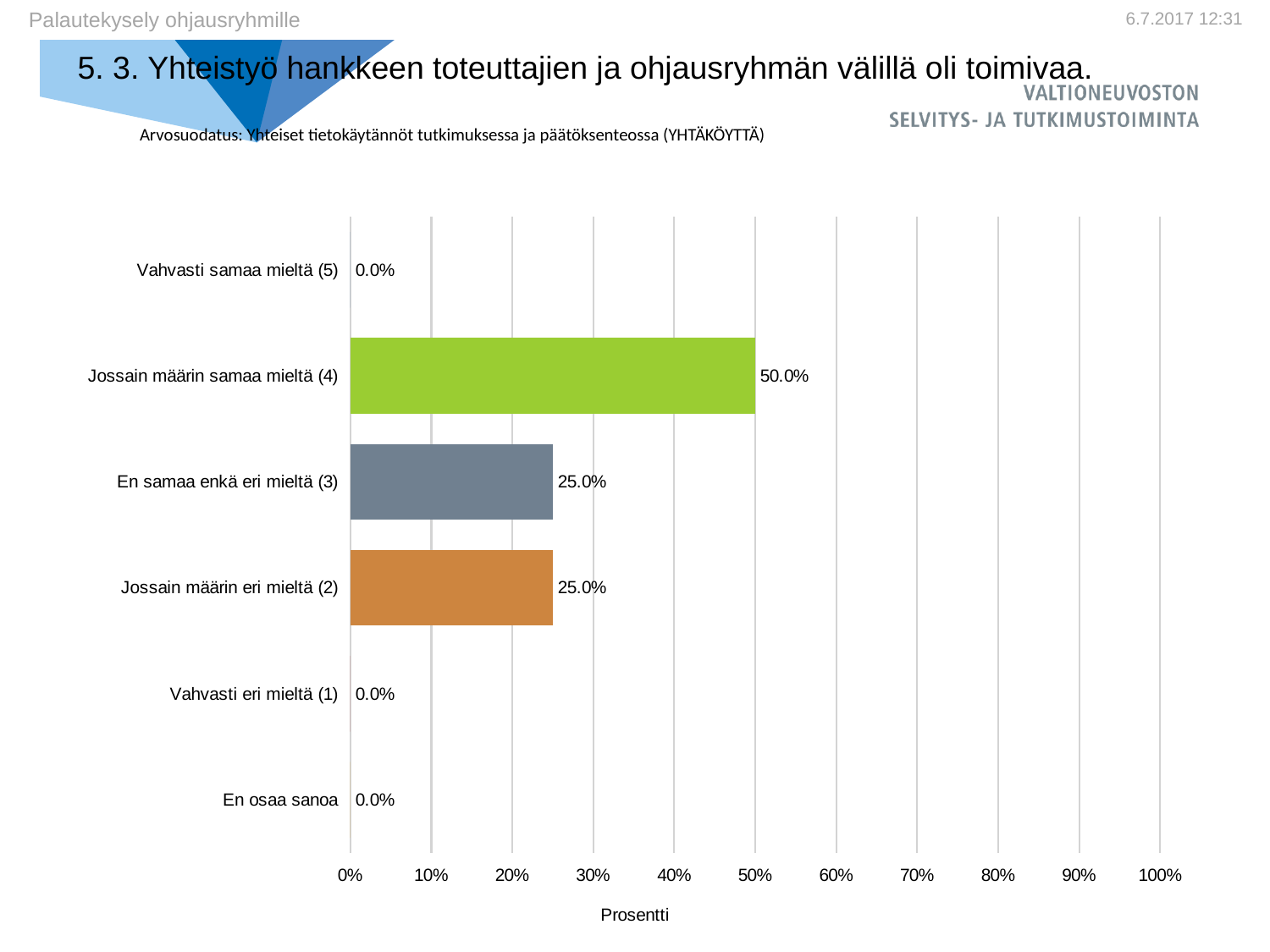
What is the value for "Jossain määrin samaa mieltä (4)"? 50.0% What is the label of the horizontal axis? Prosentti What is the maximum value shown on the horizontal axis? 100% Which category has the highest value? Jossain määrin samaa mieltä (4) How many categories are shown on the chart? 6 What is the value for "En samaa enkä eri mieltä (3)"? 25.0% What is the value for "Vahvasti samaa mieltä (5)"? 0.0% What kind of chart is shown on the slide? bar chart What is the value for "En osaa sanoa"? 0.0% What is the difference between the values for "Jossain määrin samaa mieltä (4)" and "Jossain määrin eri mieltä (2)"? 25.0% Which is larger, the value for "Jossain määrin samaa mieltä (4)" or the value for "En samaa enkä eri mieltä (3)"? Jossain määrin samaa mieltä (4) Is the value for "Jossain määrin eri mieltä (2)" greater or less than 40%? less